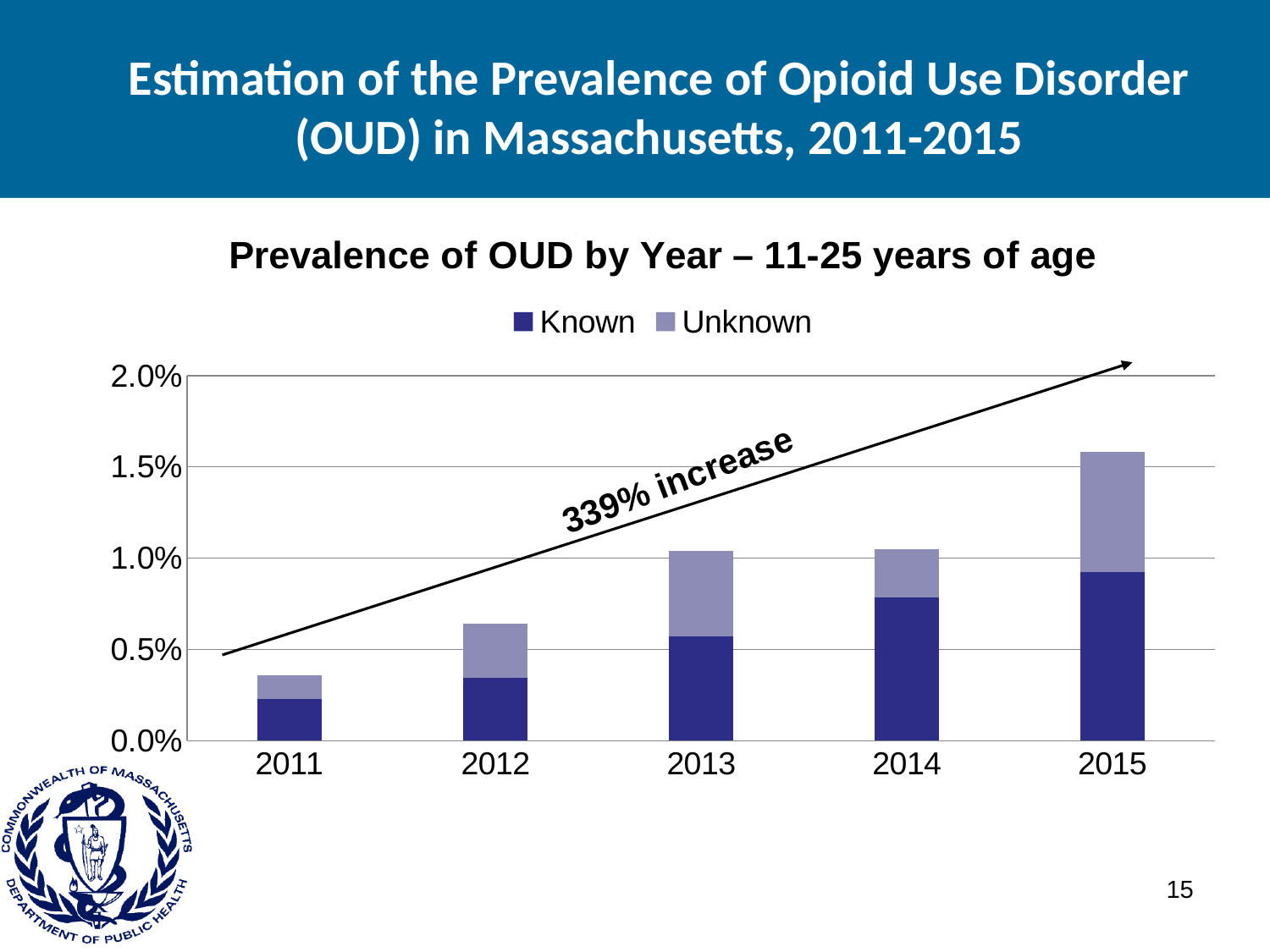
Which year has a larger total prevalence, 2012 or 2015? 2015 Is the Known value for 2015 greater or less than 1.0%? less How many years are shown on the x axis of the chart? 5 Is the total prevalence for 2012 greater or less than 0.5%? greater Is the total prevalence for 2011 greater or less than 0.5%? less Which year has the lowest total prevalence of OUD in the chart? 2011 How many series does the chart's legend list? 2 Which year has the highest total prevalence of OUD in the chart? 2015 What kind of chart is shown on the slide? Stacked bar chart What percentage increase is written on the arrow annotation in the chart? 339% increase Does the total prevalence of OUD generally rise or fall from 2011 to 2015? Rise